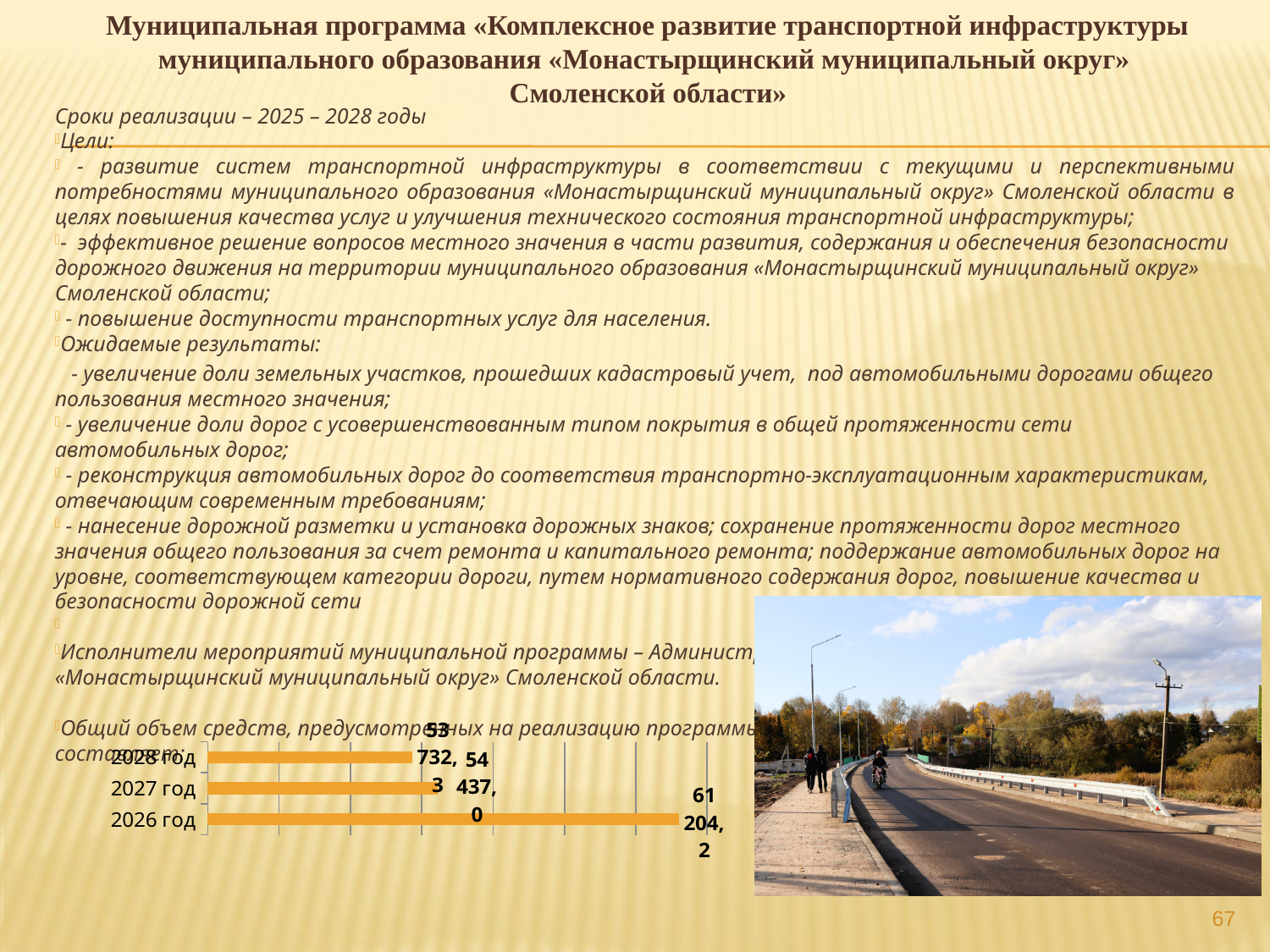
What kind of chart is shown at the bottom of the slide? bar chart What colour are the bars in the chart? orange Which year has the highest value in the bar chart? 2026 год Which is larger in the bar chart, the value for 2027 год or for 2028 год? 2027 год Which year is listed at the top of the bar chart? 2028 год What is the value shown for 2026 год in the bar chart? 61 204,2 How many categories (years) does the bar chart show? 3 Which year has the lowest value in the bar chart? 2028 год Which is larger in the bar chart, the value for 2026 год or for 2028 год? 2026 год